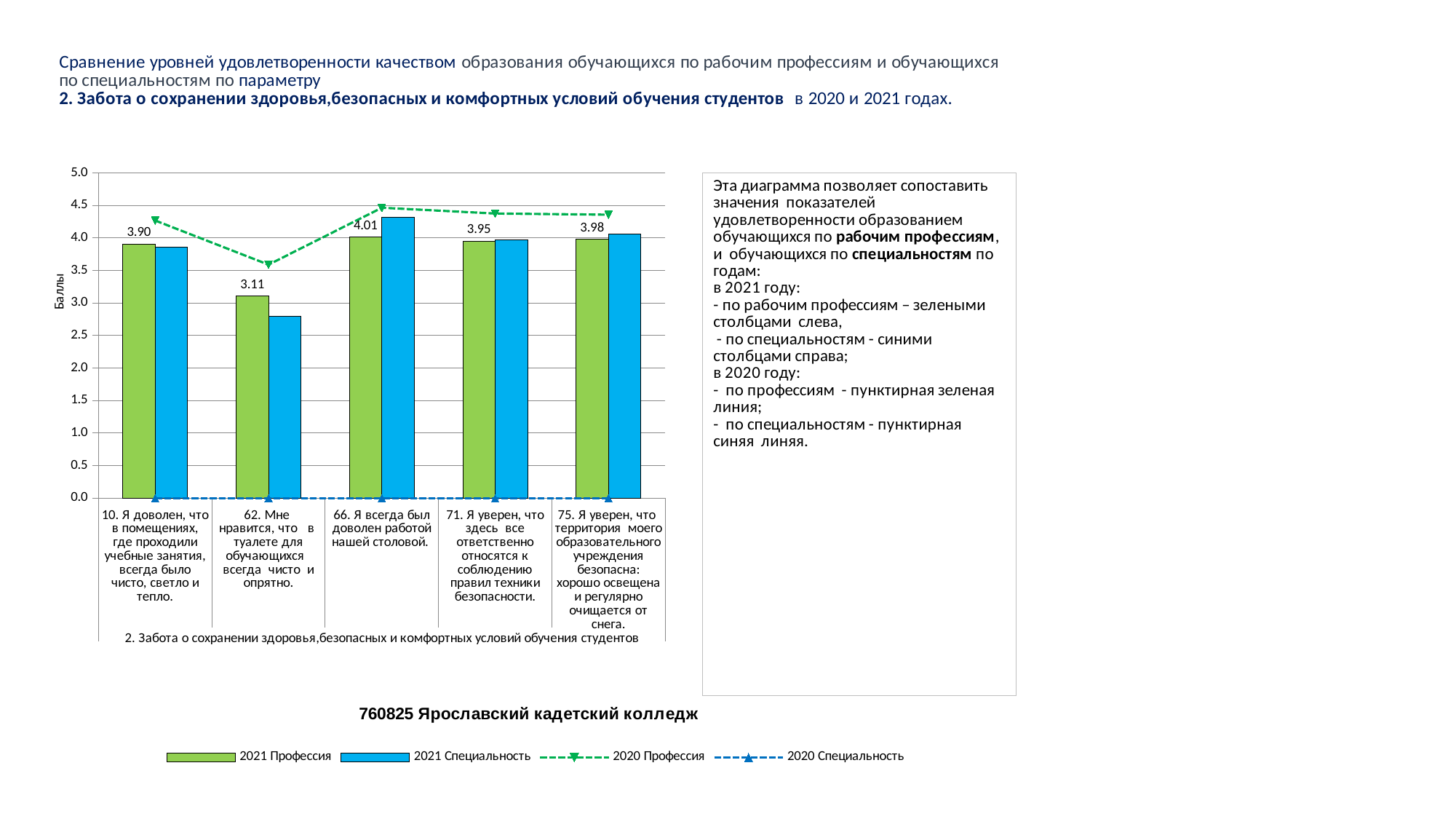
What is the 2021 Профессия value for question 62 ("Мне нравится, что в туалете для обучающихся всегда чисто и опрятно")? 3.11 How many series does the chart legend list? 4 What is the 2021 Профессия value for question 66 ("Я всегда был доволен работой нашей столовой")? 4.01 How many questions (categories) are shown on the x axis of the chart? 5 Which question has the lowest 2021 Профессия value? 62. Мне нравится, что в туалете для обучающихся всегда чисто и опрятно. What is the difference between the 2021 Профессия values for question 66 and question 62? 0.90 Is the 2021 Специальность value for question 66 greater or less than 4.0? greater For question 62, which is larger: the 2021 Профессия bar or the 2021 Специальность bar? 2021 Профессия Which question has the highest 2021 Профессия value? 66. Я всегда был доволен работой нашей столовой. Is the 2021 Специальность value for question 62 greater or less than 3.0? less What is the title of the vertical axis of the chart? Баллы What kind of chart is shown on the slide? Bar chart combined with line series